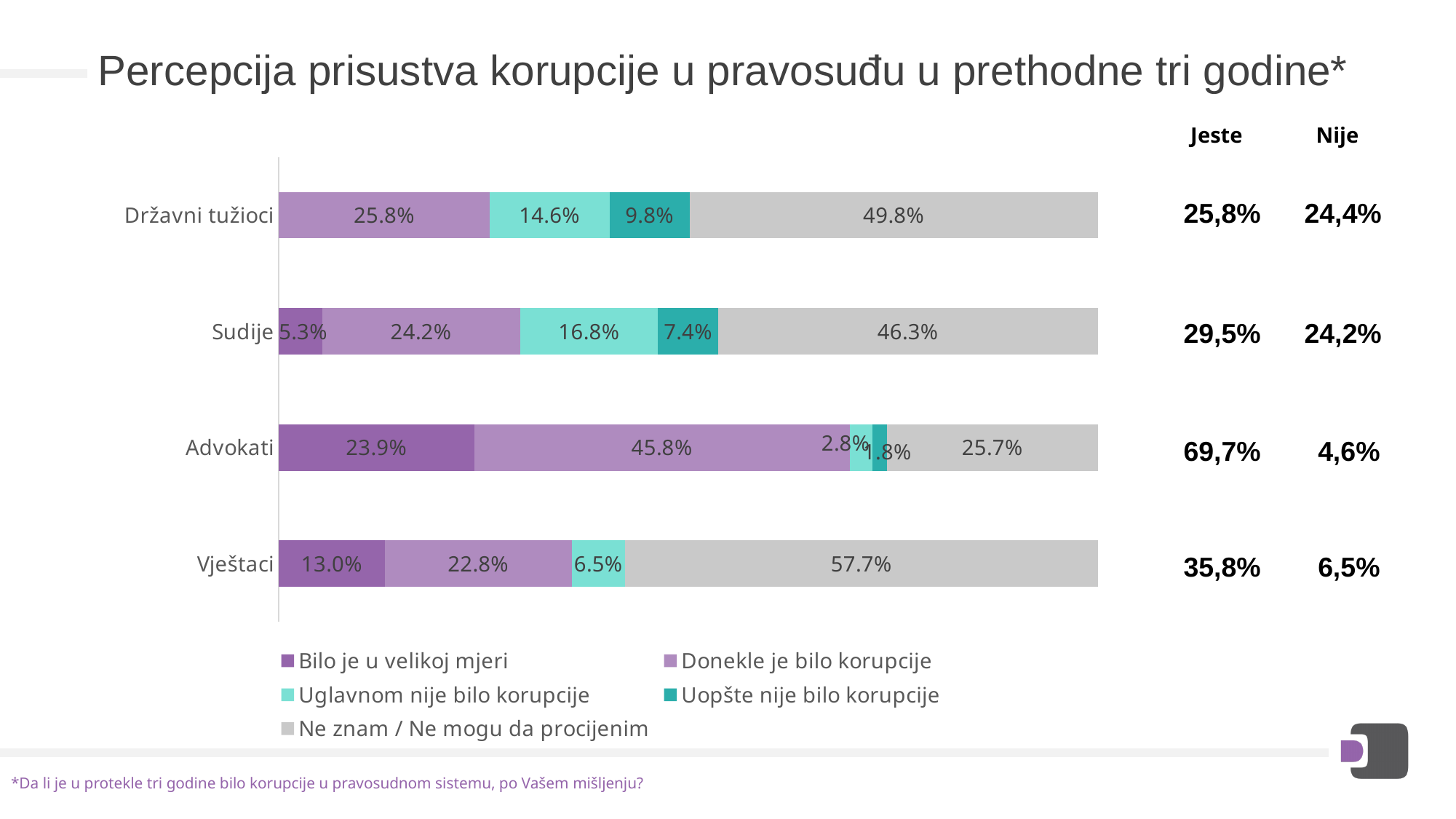
How many groups (categories) are shown on the chart? 4 What is the value of "Bilo je u velikoj mjeri" for Sudije? 5.3% What is the value of "Donekle je bilo korupcije" for Advokati? 45.8% How many series does the legend list? 5 Which legend entry is shown in grey? Ne znam / Ne mogu da procijenim What is the combined share of "Bilo je u velikoj mjeri" and "Donekle je bilo korupcije" for Advokati? 69.7% How much larger is the "Uglavnom nije bilo korupcije" value for Sudije than for Državni tužioci? 2.2 percentage points Which has a larger "Uopšte nije bilo korupcije" value, Državni tužioci or Sudije? Državni tužioci Which group has the lowest value for "Donekle je bilo korupcije"? Vještaci What percentage of Vještaci answered "Ne znam / Ne mogu da procijenim"? 57.7% What kind of chart is shown on the slide? Stacked bar chart Which group has the highest share of "Ne znam / Ne mogu da procijenim"? Vještaci